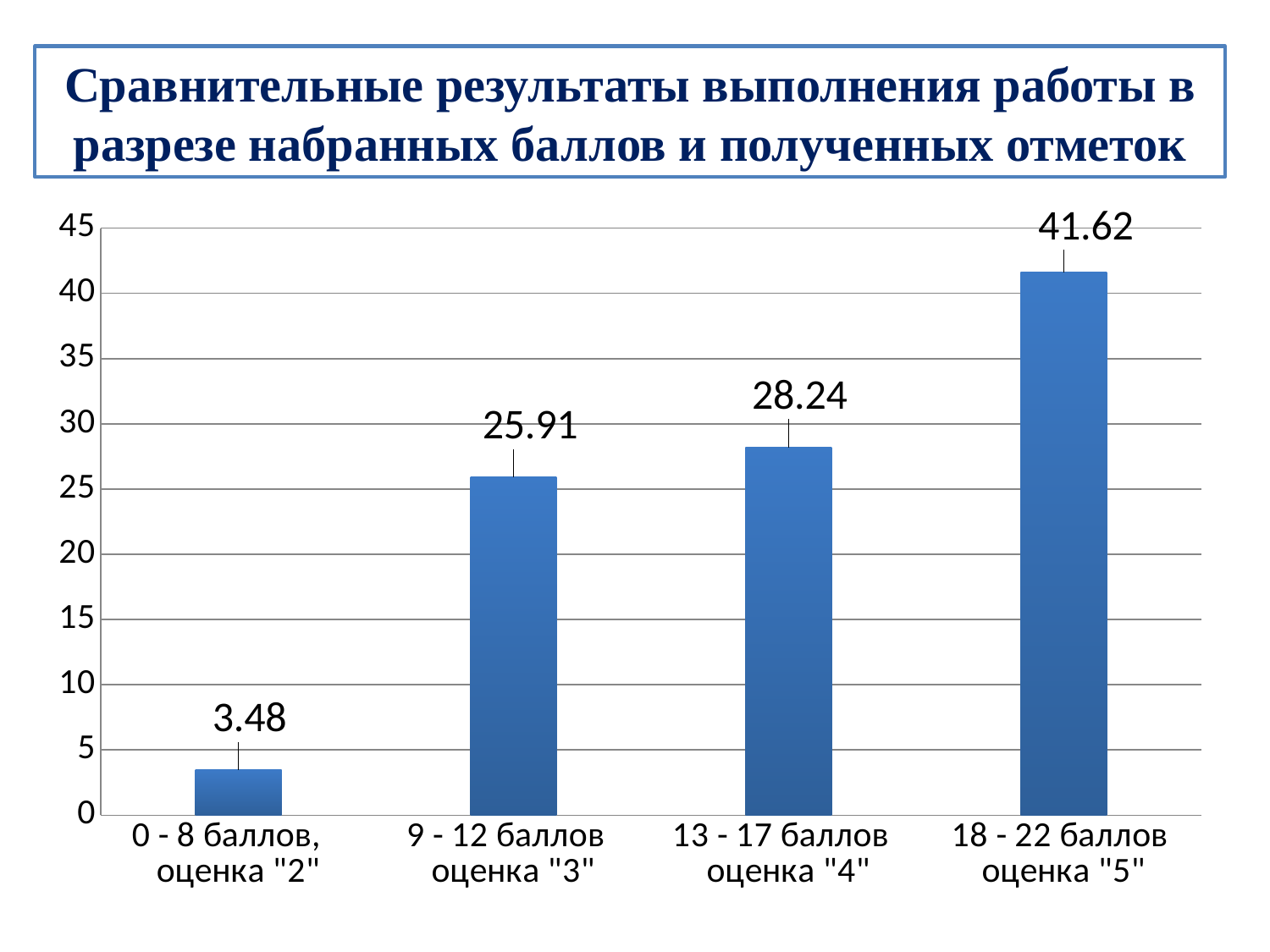
Which category has the highest value? 18 - 22 баллов оценка "5" Which is larger: the value for '9 - 12 баллов оценка "3"' or the value for '13 - 17 баллов оценка "4"'? 13 - 17 баллов оценка "4" What is the difference between the values for '18 - 22 баллов оценка "5"' and '13 - 17 баллов оценка "4"'? 13.38 What kind of chart is shown on the slide? bar chart How many categories are shown on the chart? 4 What is the value for the category '13 - 17 баллов оценка "4"'? 28.24 Is the value for '9 - 12 баллов оценка "3"' greater or less than 30? less What is the value for the category '0 - 8 баллов, оценка "2"'? 3.48 Do the values rise or fall from left to right along the x axis? rise Which category has the lowest value? 0 - 8 баллов, оценка "2" What is the value for the category '18 - 22 баллов оценка "5"'? 41.62 What is the value for the category '9 - 12 баллов оценка "3"'? 25.91